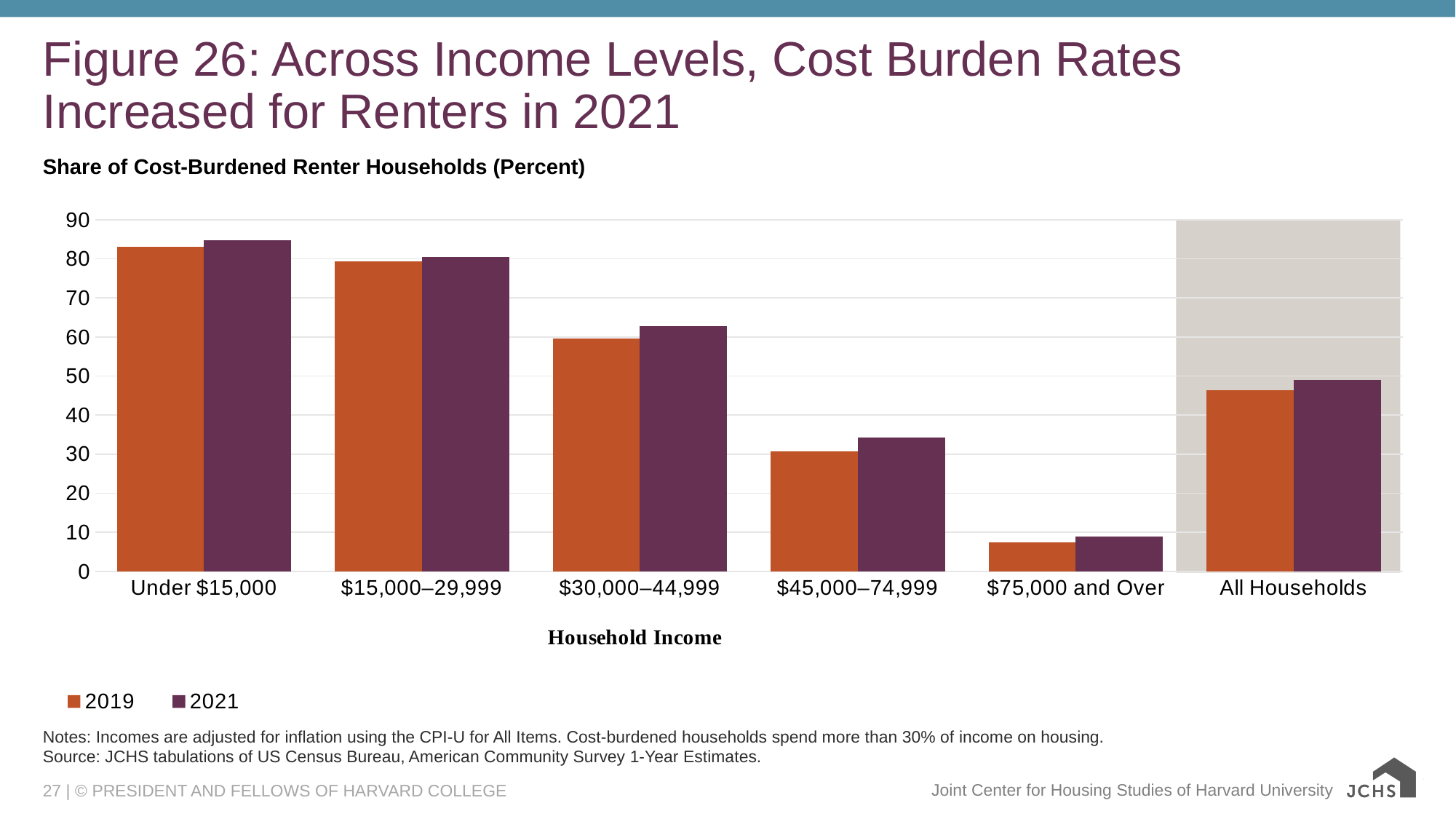
What kind of chart is shown on the slide? bar chart Is the 2019 value for $45,000–74,999 greater or less than 40? less Which household income category has the lowest share of cost-burdened renter households in 2019? $75,000 and Over Is the 2021 value for $75,000 and Over greater or less than 10? less How many household income categories are shown on the x axis? 6 How many series does the legend list? 2 Which series is shown in orange in the legend? 2019 For the $30,000–44,999 category, which year has the larger share of cost-burdened renter households, 2019 or 2021? 2021 Is the 2019 value for All Households greater or less than 50? less Which household income category has the highest share of cost-burdened renter households in 2021? Under $15,000 Moving from Under $15,000 to $75,000 and Over, do the cost burden rates rise or fall? fall